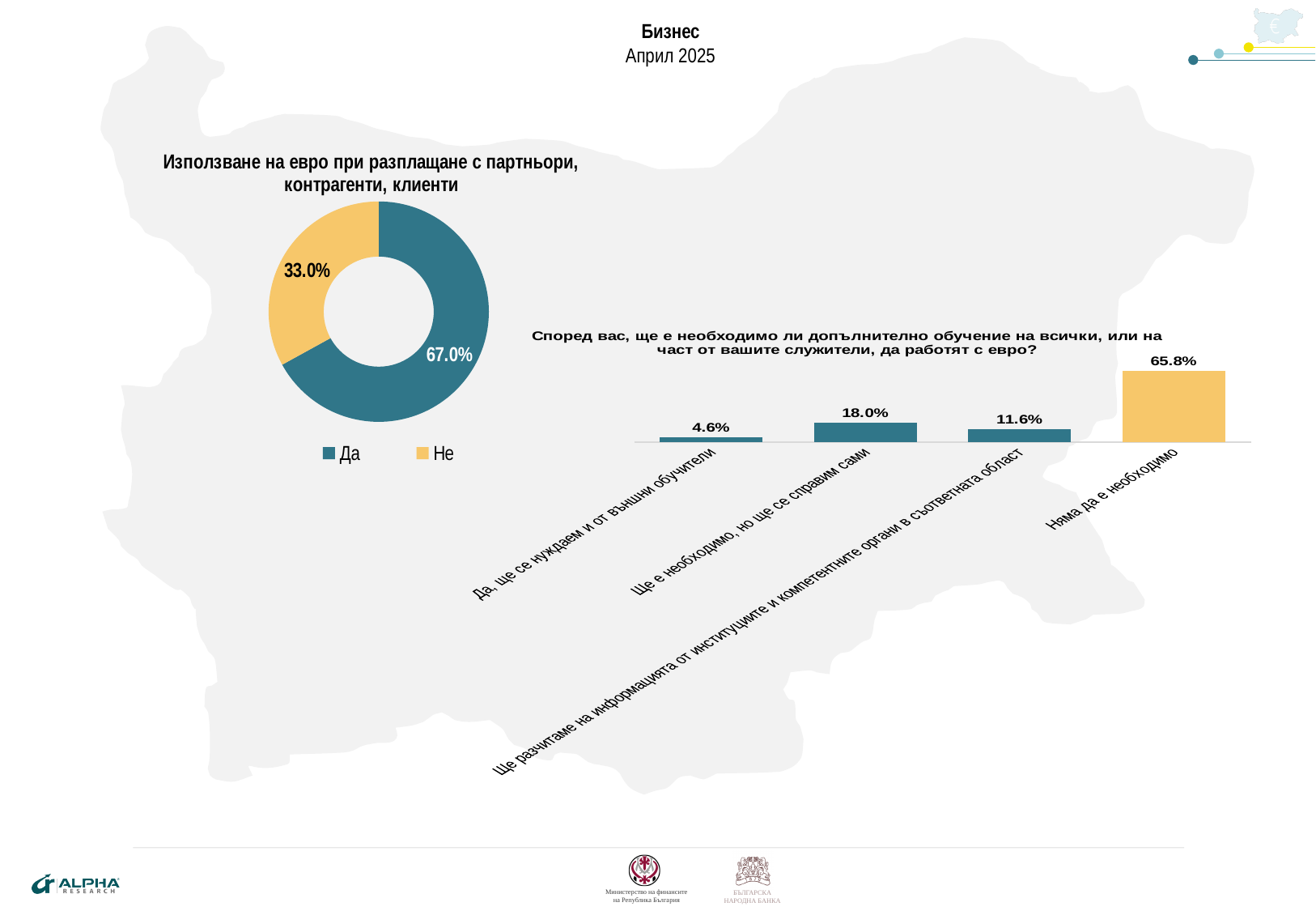
In the bar chart on the right, how many categories are shown? 4 In the bar chart 'Според вас, ще е необходимо ли допълнително обучение...', what is the value for 'Ще е необходимо, но ще се справим сами'? 18.0% In the bar chart 'Според вас, ще е необходимо ли допълнително обучение...', what is the value for 'Да, ще се нуждаем и от външни обучители'? 4.6% How many entries does the legend of the doughnut chart on the left list? 2 In the doughnut chart 'Използване на евро при разплащане с партньори, контрагенти, клиенти', what is the value for 'Не'? 33.0% In the doughnut chart 'Използване на евро при разплащане с партньори, контрагенти, клиенти', what is the value for 'Да'? 67.0% In the bar chart on the right, which category has the lowest value? Да, ще се нуждаем и от външни обучители In the bar chart 'Според вас, ще е необходимо ли допълнително обучение...', what is the value for 'Няма да е необходимо'? 65.8% What type of chart is the chart on the left of the slide? Doughnut chart In the doughnut chart on the left, what is the difference between the 'Да' and 'Не' shares? 34.0% In the doughnut chart on the left, which category has the larger share, 'Да' or 'Не'? Да In the bar chart on the right, what is the difference between 'Ще е необходимо, но ще се справим сами' and 'Ще разчитаме на информацията от институциите и компетентните органи в съответната област'? 6.4%